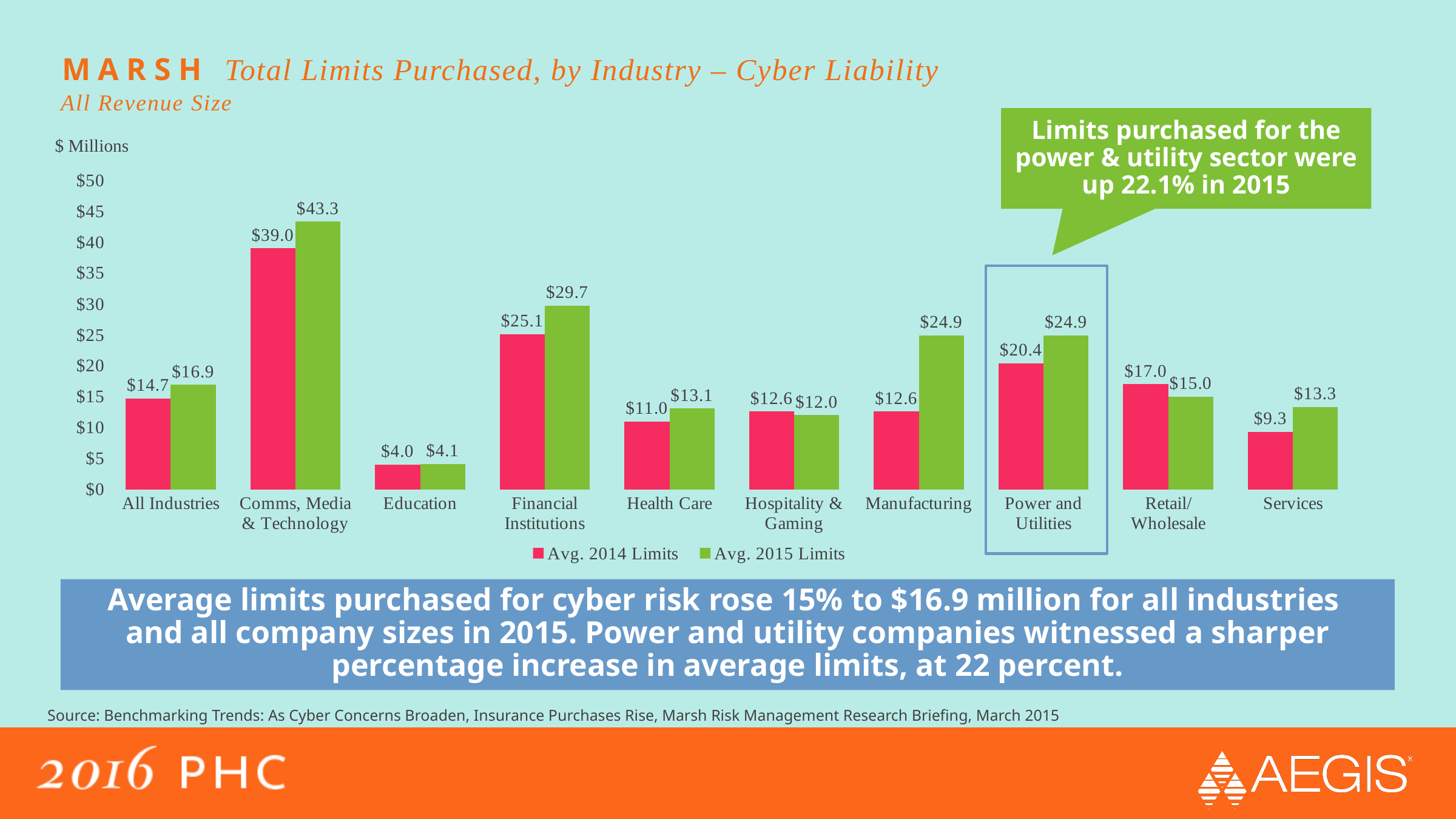
What is the Avg. 2015 Limits value for Comms, Media & Technology? $43.3 How many industry categories are shown on the x axis? 10 Is the Avg. 2015 Limits value for Manufacturing greater or less than $20? greater What kind of chart is shown on the slide? Bar chart Which industry has the lowest Avg. 2014 Limits? Education Which is larger for Retail/Wholesale: Avg. 2014 Limits or Avg. 2015 Limits? Avg. 2014 Limits What is the Avg. 2014 Limits value for Power and Utilities? $20.4 What is the difference between the Avg. 2015 Limits and Avg. 2014 Limits for Financial Institutions? $4.6 Which industry has the highest Avg. 2015 Limits? Comms, Media & Technology How many series does the legend list? 2 What unit is shown for the y axis of the chart? $ Millions What is the Avg. 2015 Limits value for Health Care? $13.1